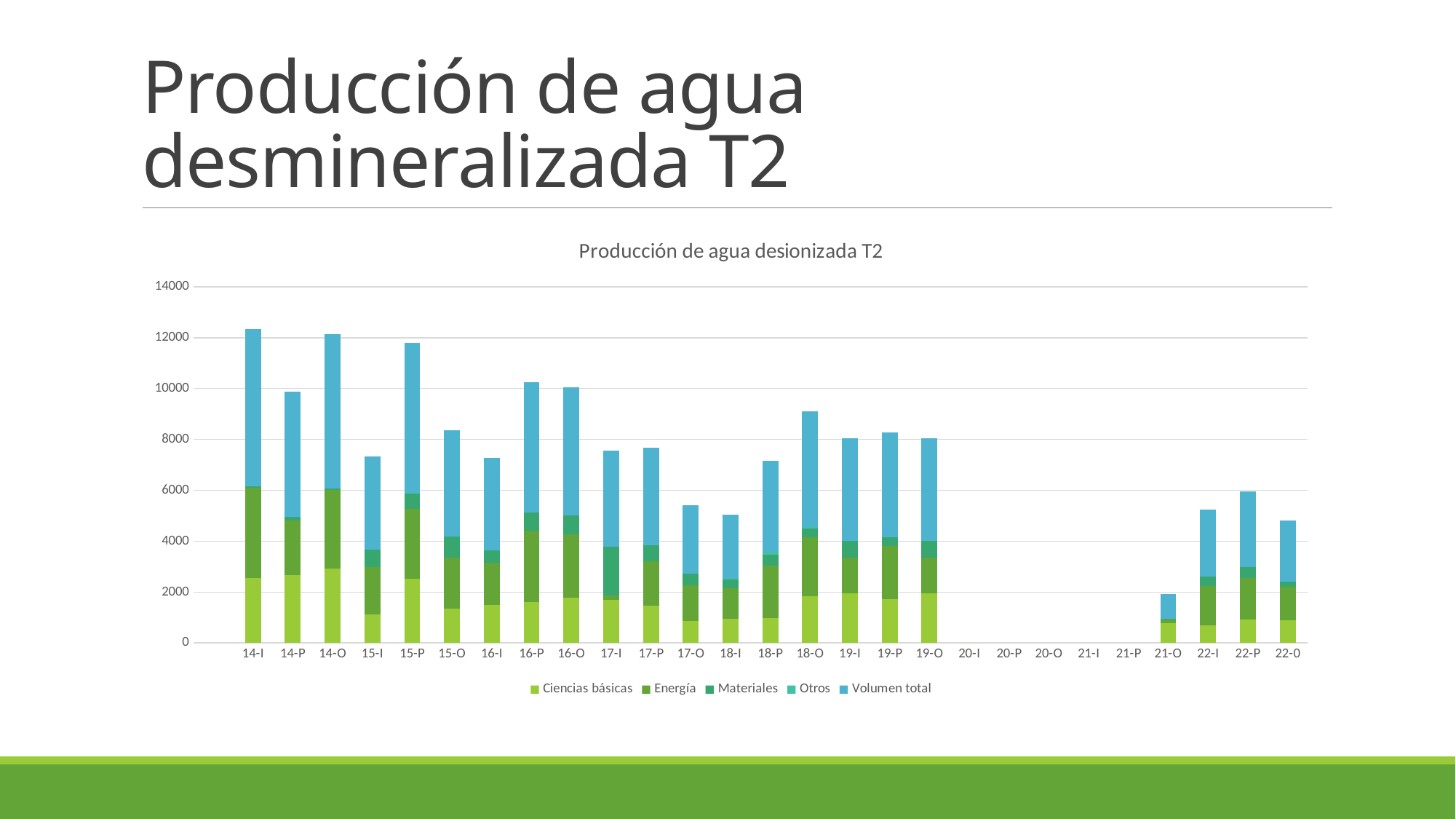
Among the categories that have bars, which has the lowest total? 21-O Is the total bar height for 14-I greater or less than 12000? greater How many categories on the x axis have no bar at all? 5 How many series does the legend list? 5 Is the total bar height for 18-O greater or less than 8000? greater Which series is shown in light blue at the top of each stacked bar? Volumen total Which has the taller total bar, 15-P or 15-O? 15-P What is the title of the chart? Producción de agua desionizada T2 What kind of chart is shown on the slide? Stacked bar chart How many categories are shown on the x axis? 27 Is the total bar height for 17-O greater or less than 6000? less